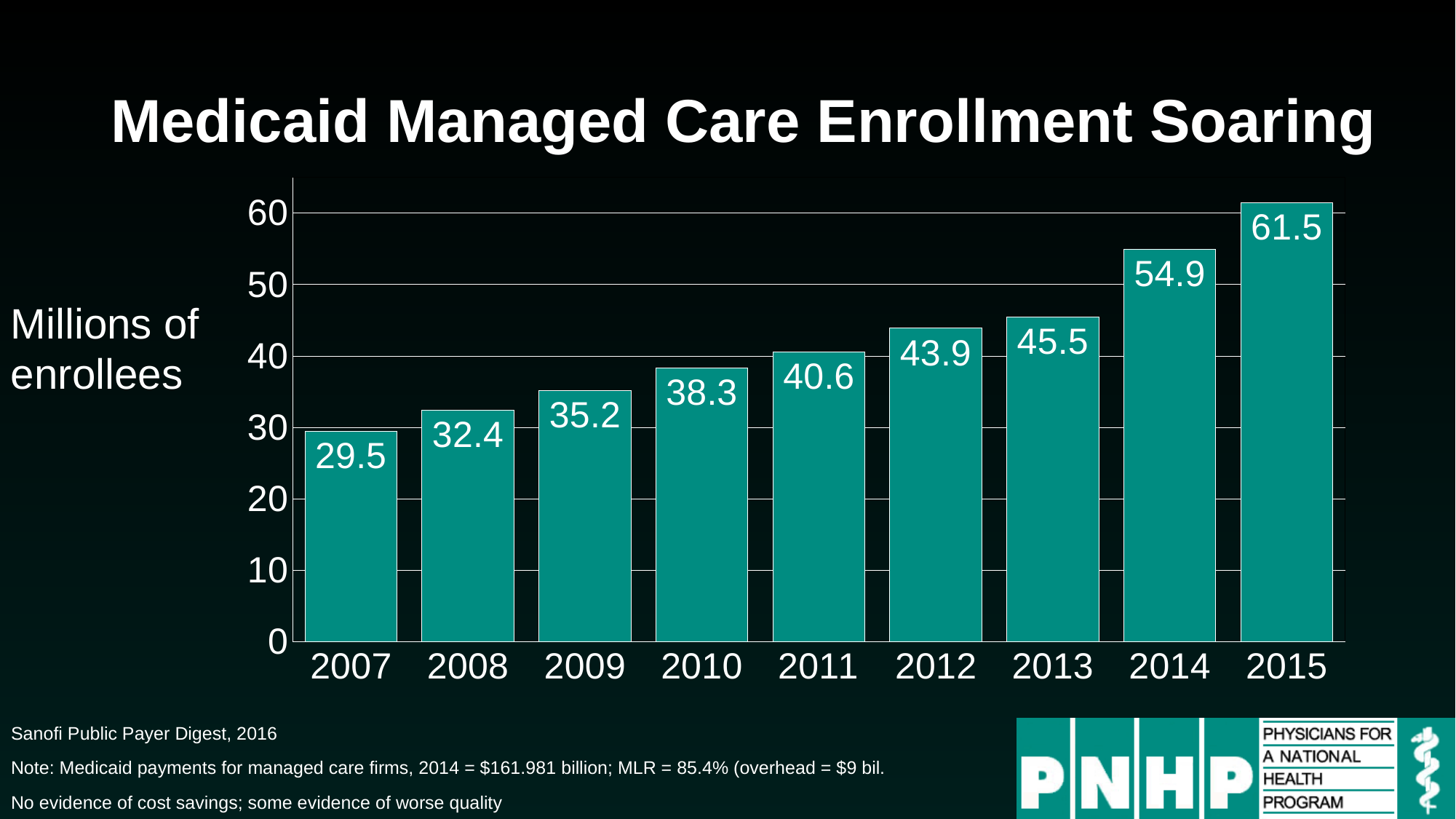
Do the values rise or fall from 2007 to 2015? rise Is the value for 2013 greater or less than 40? greater What is the value for 2014? 54.9 What is the difference between the values for 2014 and 2013? 9.4 What is the value for 2007? 29.5 Which year has the highest value? 2015 How many years are shown on the x axis? 9 Which year has the lowest value? 2007 What is the difference between the values for 2015 and 2007? 32 What kind of chart is shown? bar chart Which is larger, the value for 2010 or the value for 2012? 2012 What is the value for 2011? 40.6